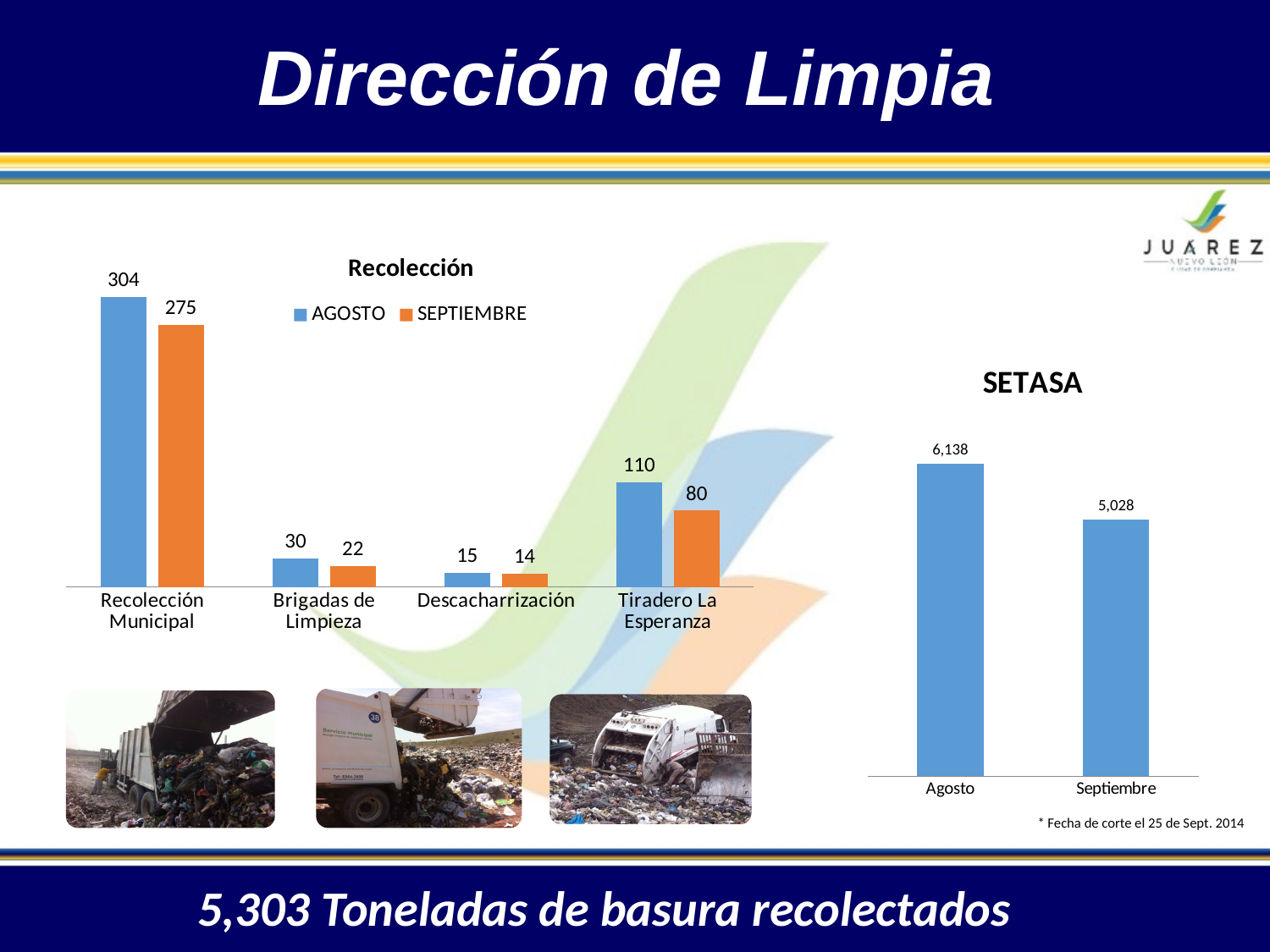
In the Recolección chart, which category has the lowest SEPTIEMBRE value? Descacharrización In the Recolección chart, which colour represents SEPTIEMBRE? Orange In the Recolección chart, what is the difference between the AGOSTO and SEPTIEMBRE values for Recolección Municipal? 29 What type of chart is the SETASA chart? Bar chart In the Recolección chart, what is the SEPTIEMBRE value for Tiradero La Esperanza? 80 In the SETASA chart, do values rise or fall from Agosto to Septiembre? Fall How many series does the legend of the Recolección chart list? 2 In the Recolección chart, what is the AGOSTO value for Recolección Municipal? 304 In the SETASA chart, what is the difference between Agosto and Septiembre? 1,110 In the Recolección chart, which is larger for Brigadas de Limpieza: AGOSTO or SEPTIEMBRE? AGOSTO How many categories are shown in the Recolección chart? 4 In the SETASA chart, what is the value for Agosto? 6,138